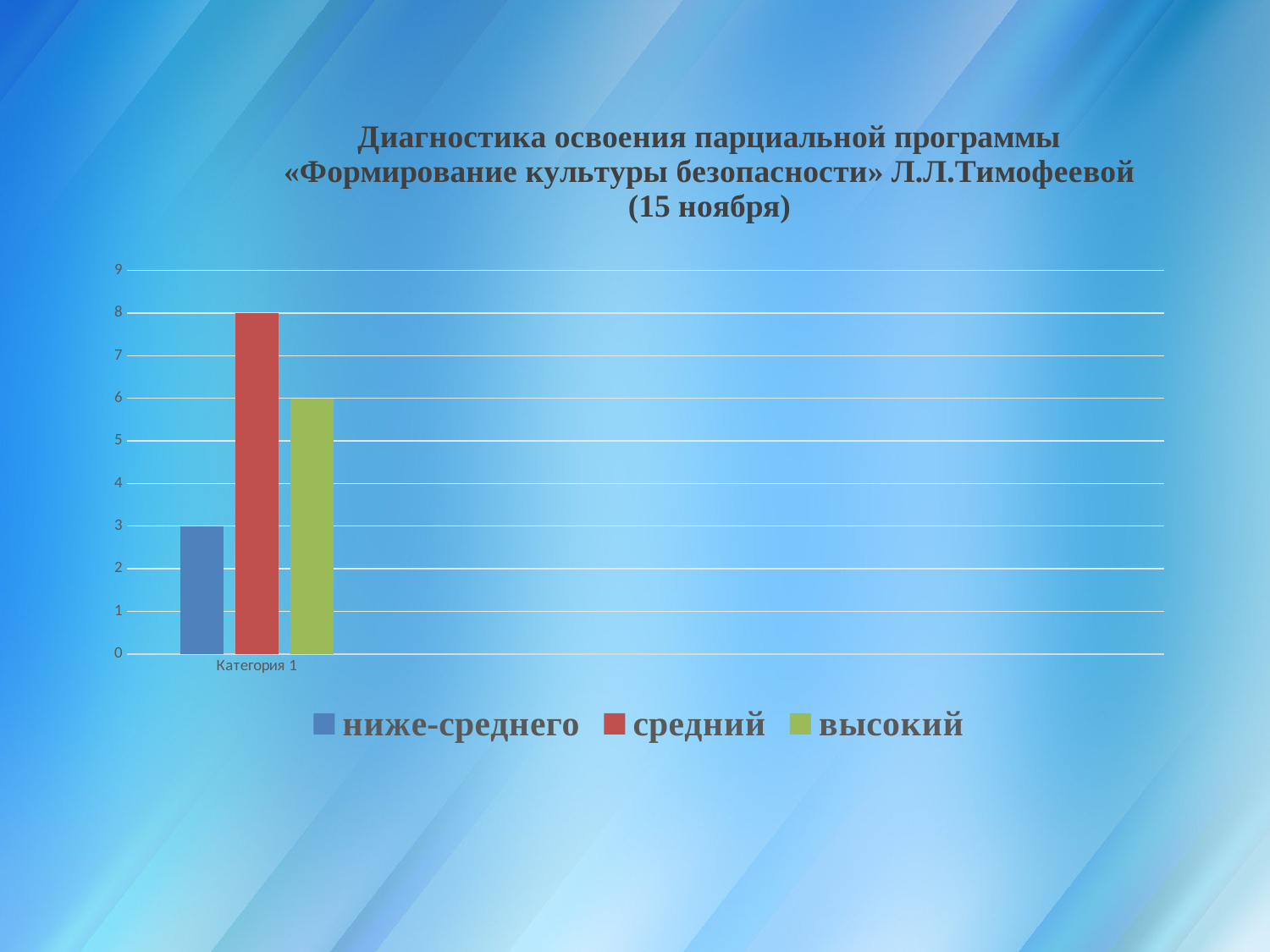
Is the value for "средний" greater or less than 5? greater What is the value of the "ниже-среднего" bar? 3 How many categories are shown on the x axis? 1 Which is larger, the "высокий" value or the "ниже-среднего" value? высокий What colour is the "высокий" series in the legend? green How many series does the legend list? 3 What is the value of the "средний" bar? 8 Which series has the lowest value? ниже-среднего What is the value of the "высокий" bar? 6 What is the difference between the "средний" and "высокий" values? 2 What kind of chart is shown on the slide? bar chart Which series has the highest value? средний